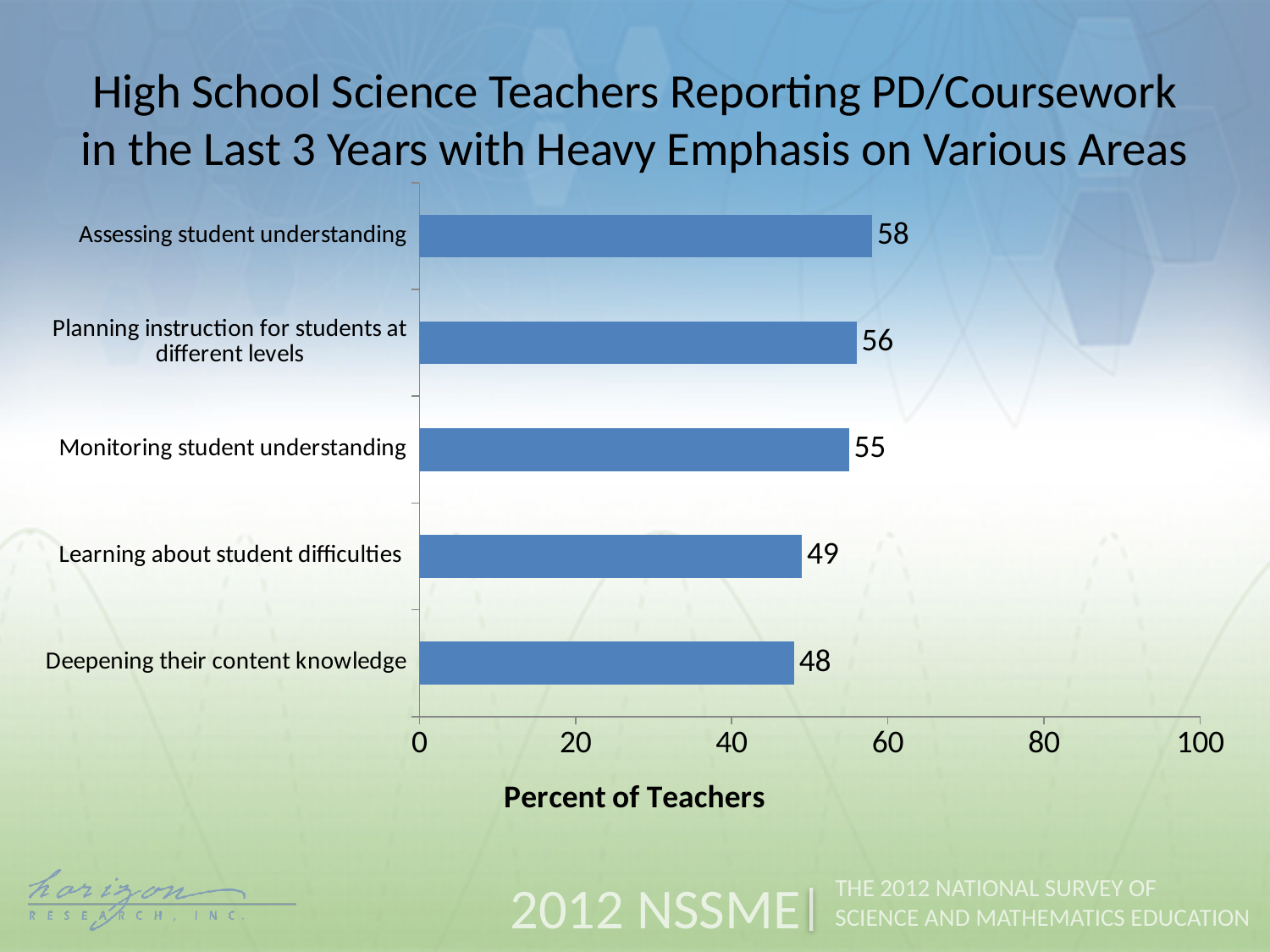
What is the label of the horizontal axis? Percent of Teachers Which area has the lowest percent of teachers? Deepening their content knowledge What is the difference between the values for 'Assessing student understanding' and 'Deepening their content knowledge'? 10 What percent of teachers reported PD/coursework with heavy emphasis on assessing student understanding? 58 How many areas are shown in the chart? 5 Is the value for 'Learning about student difficulties' greater or less than 60? less What kind of chart is shown on the slide? Bar chart Which area has the highest percent of teachers? Assessing student understanding What is the value for 'Monitoring student understanding'? 55 What is the value for 'Deepening their content knowledge'? 48 What is the difference between the values for 'Planning instruction for students at different levels' and 'Learning about student difficulties'? 7 Which is larger: the value for 'Monitoring student understanding' or 'Learning about student difficulties'? Monitoring student understanding